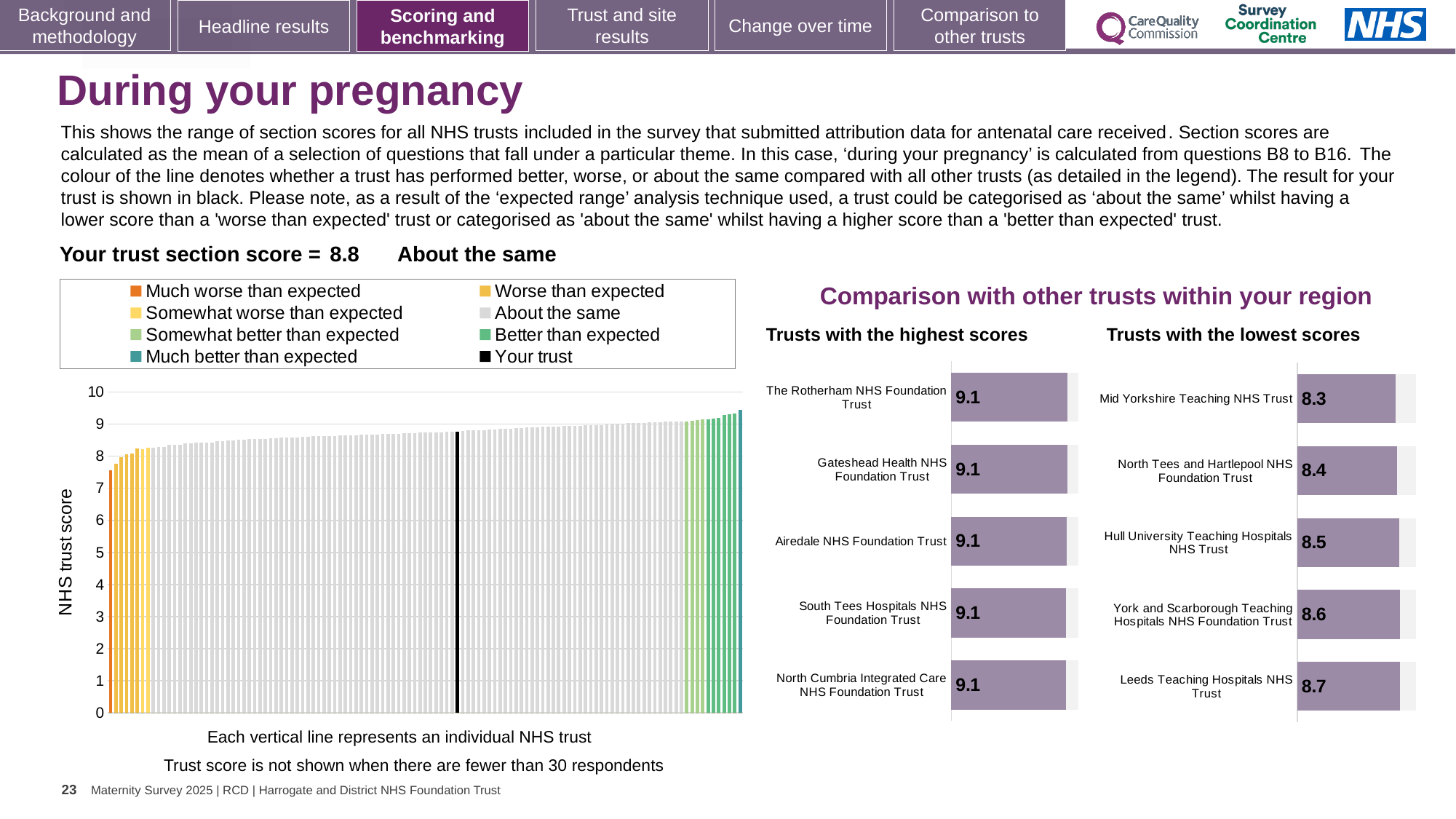
In the 'Trusts with the lowest scores' chart, which has the higher score: North Tees and Hartlepool NHS Foundation Trust or York and Scarborough Teaching Hospitals NHS Foundation Trust? York and Scarborough Teaching Hospitals NHS Foundation Trust In the 'Trusts with the lowest scores' chart, which trust has the lowest score? Mid Yorkshire Teaching NHS Trust In the 'Trusts with the lowest scores' chart, what is the difference between the scores of Leeds Teaching Hospitals NHS Trust and Mid Yorkshire Teaching NHS Trust? 0.4 In the 'Trusts with the lowest scores' chart, what is the score for Hull University Teaching Hospitals NHS Trust? 8.5 How many entries does the legend above the large chart on the left list? 8 What is the section score for your trust shown on the slide? 8.8 How many trusts are shown in the 'Trusts with the highest scores' chart? 5 In the large chart on the left, is the value of the black bar (your trust) greater or less than 8? greater In the 'Trusts with the highest scores' chart, what is the score for Airedale NHS Foundation Trust? 9.1 In the large chart on the left, do the bars rise or fall from left to right? rise In the large chart on the left, is the value of the leftmost (orange) bar greater or less than 8? less What kind of chart is the large chart on the left with the y axis labelled 'NHS trust score'? bar chart